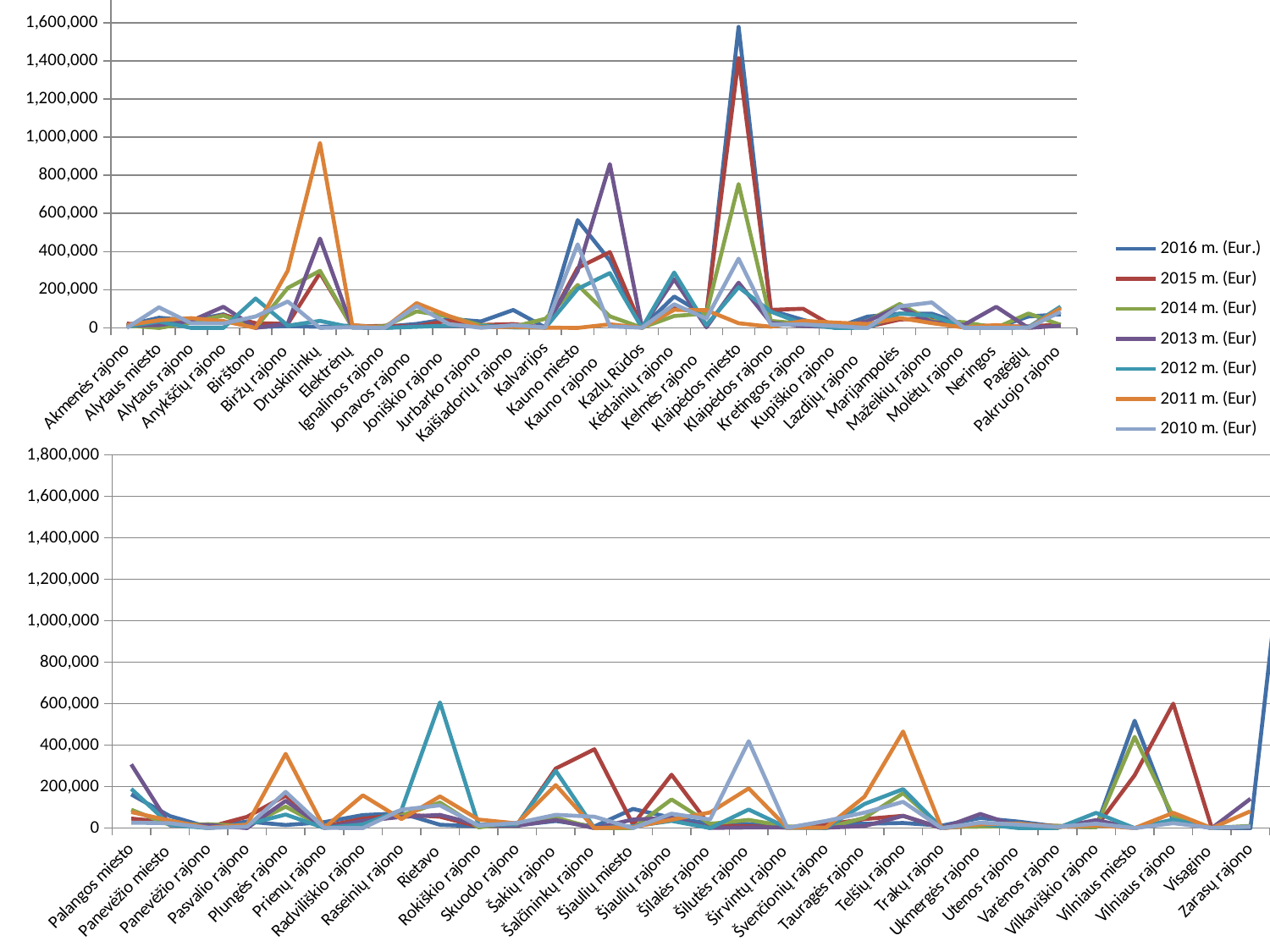
In the bottom chart, which is larger: the 2015 m. (Eur) value for Vilniaus rajono or the 2016 m. (Eur.) value for Vilniaus miesto? 2015 m. (Eur) value for Vilniaus rajono What kind of chart is the top chart on the slide? line chart In the top chart, which municipality has the highest value for the 2011 m. (Eur) series? Druskininkų In the bottom chart, is the 2011 m. (Eur) value for Telšių rajono greater or less than 400,000? greater In the top chart, which municipality has the highest value for the 2016 m. (Eur.) series? Klaipėdos miesto How many series does the legend list? 7 In the top chart, which municipality has the highest value for the 2013 m. (Eur) series? Kauno rajono What is the highest value shown on the y axis of the bottom chart? 1,800,000 In the top chart, is the 2011 m. (Eur) value for Druskininkų greater or less than 800,000? greater How many municipalities are shown on the x axis of the bottom chart? 30 In the top chart, is the 2016 m. (Eur.) value for Klaipėdos miesto greater or less than 1,400,000? greater